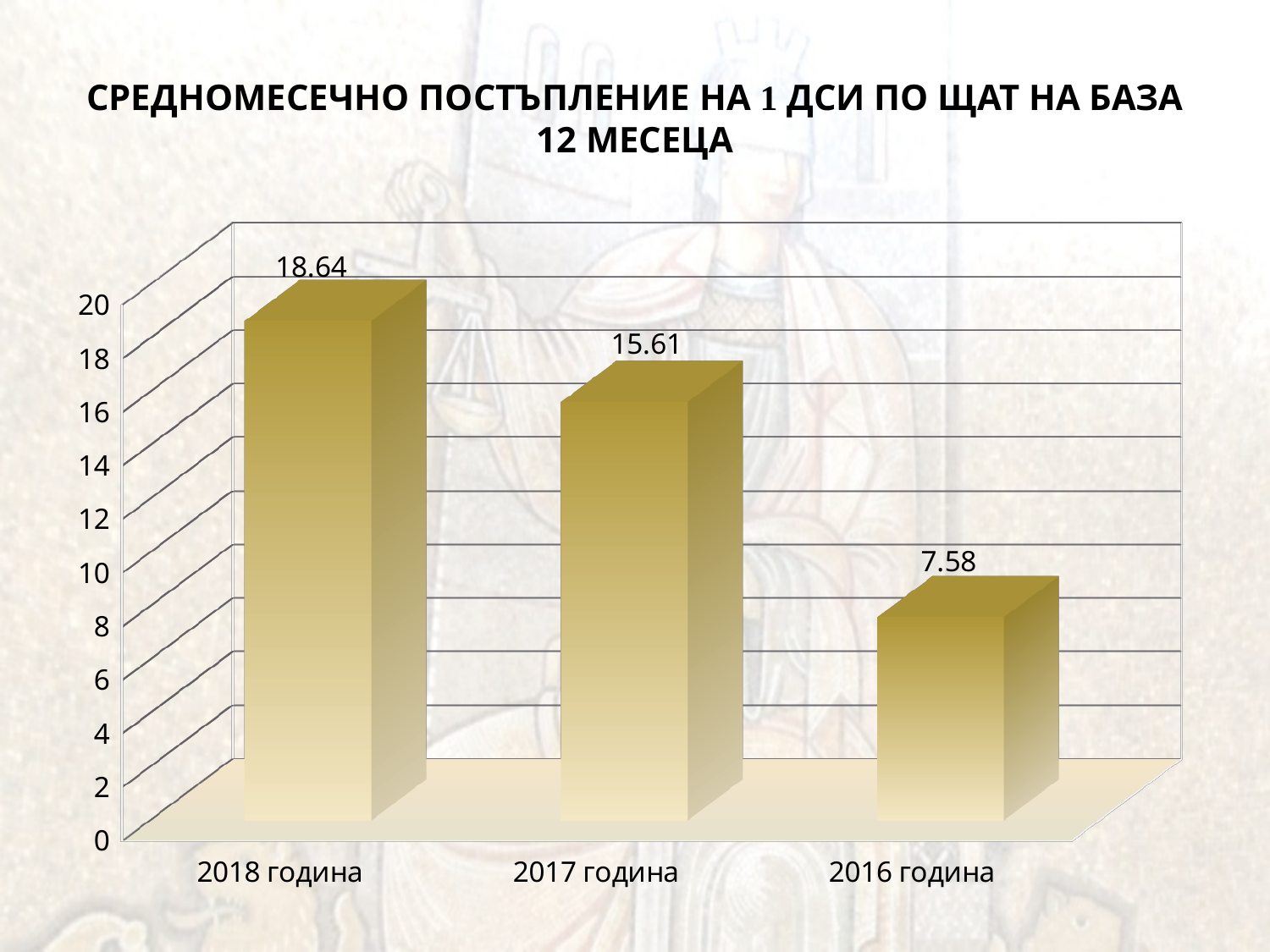
What kind of chart is shown on the slide? bar chart What is the value for 2017 година? 15.61 What is the difference between the values for 2018 година and 2017 година? 3.03 What is the value for 2018 година? 18.64 What is the value for 2016 година? 7.58 What is the difference between the values for 2017 година and 2016 година? 8.03 How many categories are shown on the chart? 3 Is the value for 2016 година greater or less than 10? less Do the values rise or fall from left to right along the x axis? fall Which year has the lowest value? 2016 година Which is larger, the value for 2017 година or the value for 2016 година? 2017 година Which year has the highest value? 2018 година